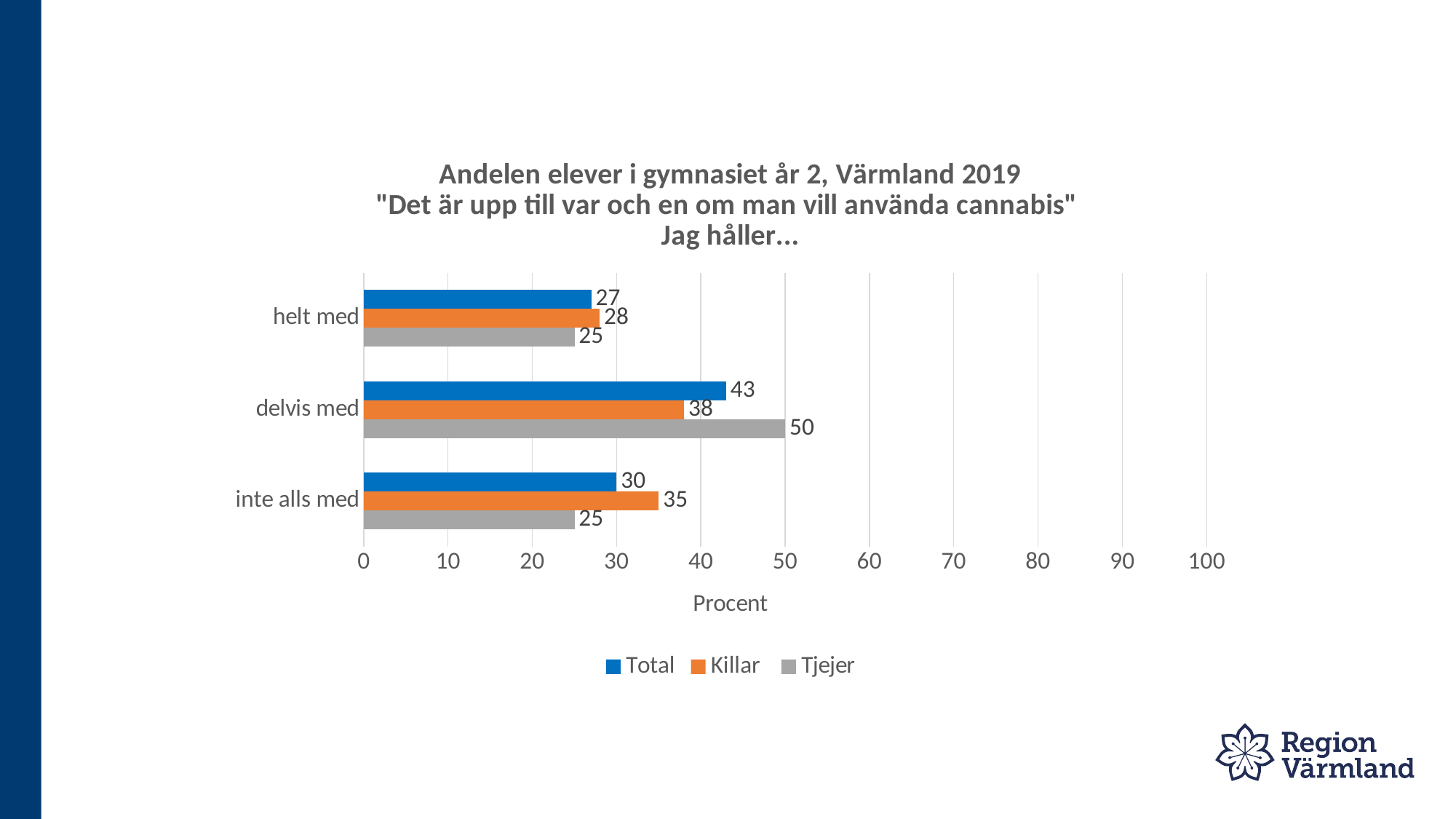
What is the difference between the Tjejer and Killar values for 'delvis med'? 12 Which is larger for 'inte alls med': the Killar value or the Tjejer value? Killar What is the label of the x axis? Procent What kind of chart is shown on the slide? bar chart What is the Total value for 'helt med'? 27 Which category has the lowest Killar value? helt med How many categories are shown on the y axis? 3 Is the Total value for 'delvis med' greater or less than 40? greater What is the value for Tjejer in the 'delvis med' category? 50 How many series does the legend list? 3 Which category has the highest Total value? delvis med What is the value for Killar in the 'inte alls med' category? 35